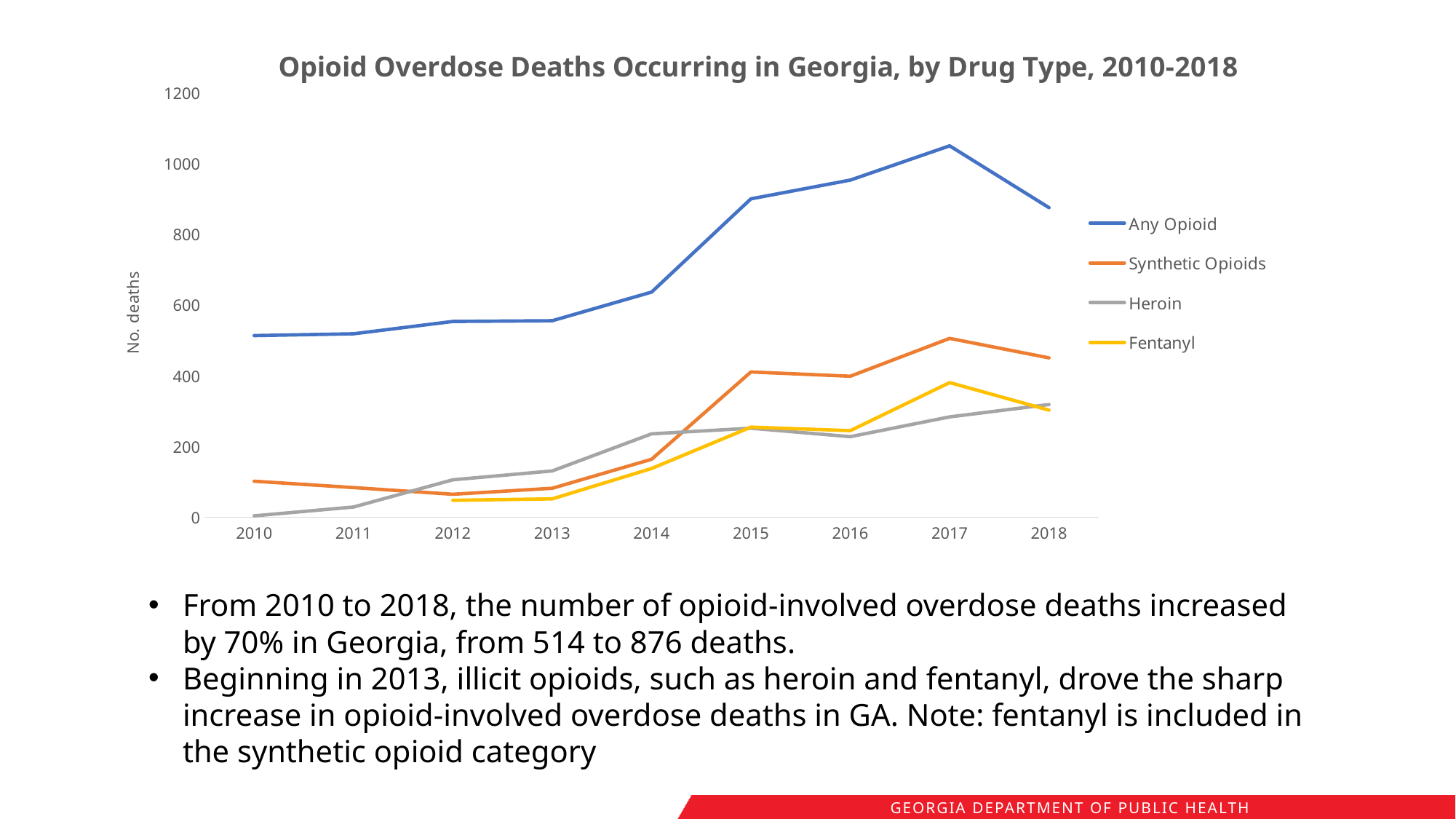
What kind of chart is shown on the slide? line chart Is the value for Any Opioid in 2017 greater or less than 1000? greater In which year does the Any Opioid line reach its peak? 2017 What is the label on the y axis? No. deaths How many years are plotted along the x axis? 9 Is the value for Synthetic Opioids in 2017 greater or less than 400? greater Which is larger in 2014, the Heroin value or the Fentanyl value? Heroin How many series does the legend list? 4 Does the Any Opioid line rise or fall from 2010 to 2017? rise In which year is the Heroin line at its lowest? 2010 Which series has the highest value in 2017? Any Opioid Is the value for Heroin in 2010 greater or less than 200? less